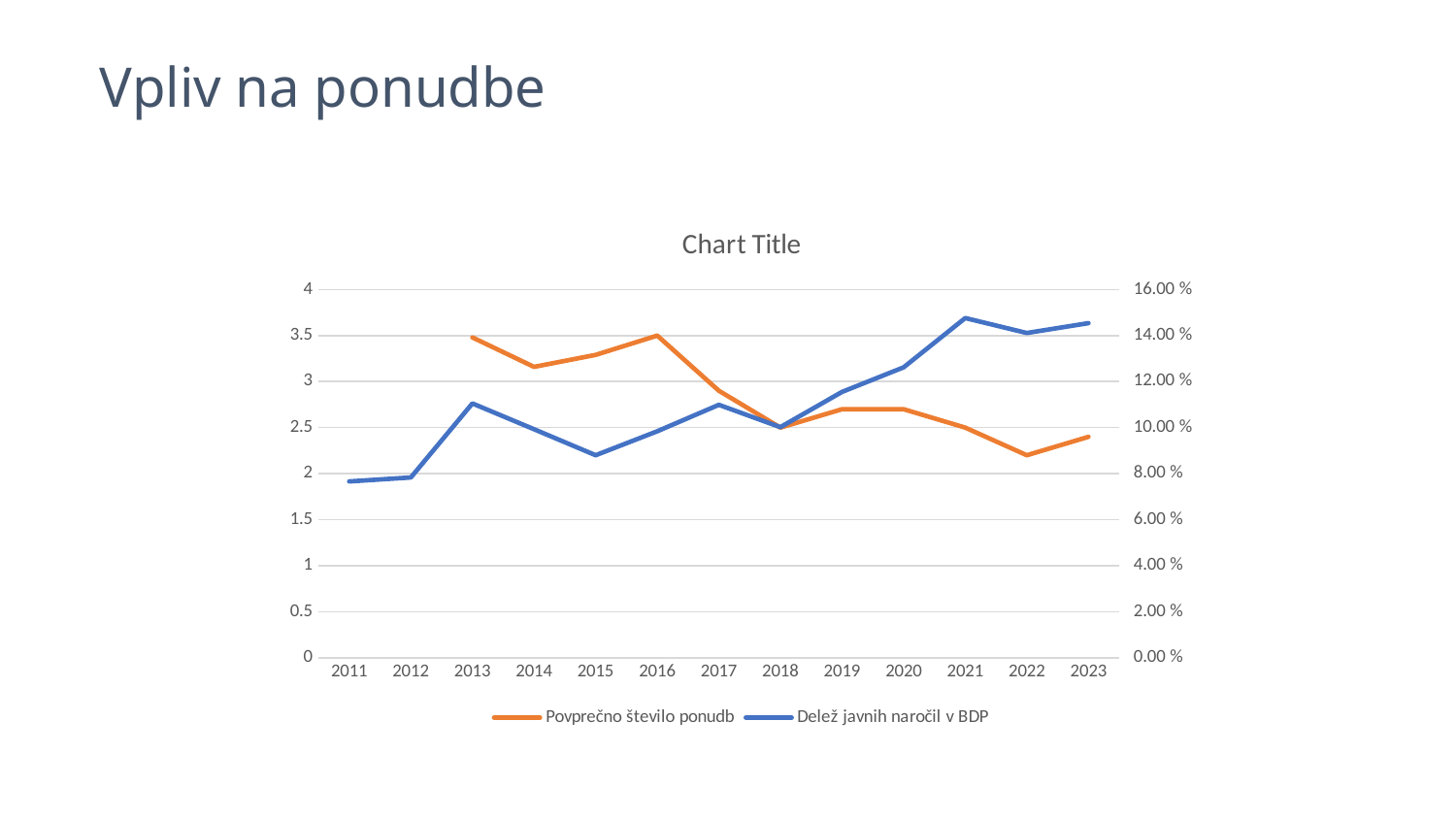
What kind of chart is shown on the slide? line chart Which series is drawn in orange? Povprečno število ponudb Is the value of Delež javnih naročil v BDP in 2011 greater or less than 8.00 %? less Which is larger for Delež javnih naročil v BDP: the value in 2020 or the value in 2015? 2020 What is the title printed above the chart? Chart Title Is the value of Povprečno število ponudb in 2022 greater or less than 2.5? less How many series does the legend list? 2 Is the value of Povprečno število ponudb in 2014 greater or less than 3? greater How many years are shown on the x axis? 13 In which year is Povprečno število ponudb at its lowest? 2022 Does Delež javnih naročil v BDP rise or fall from 2018 to 2021? rise